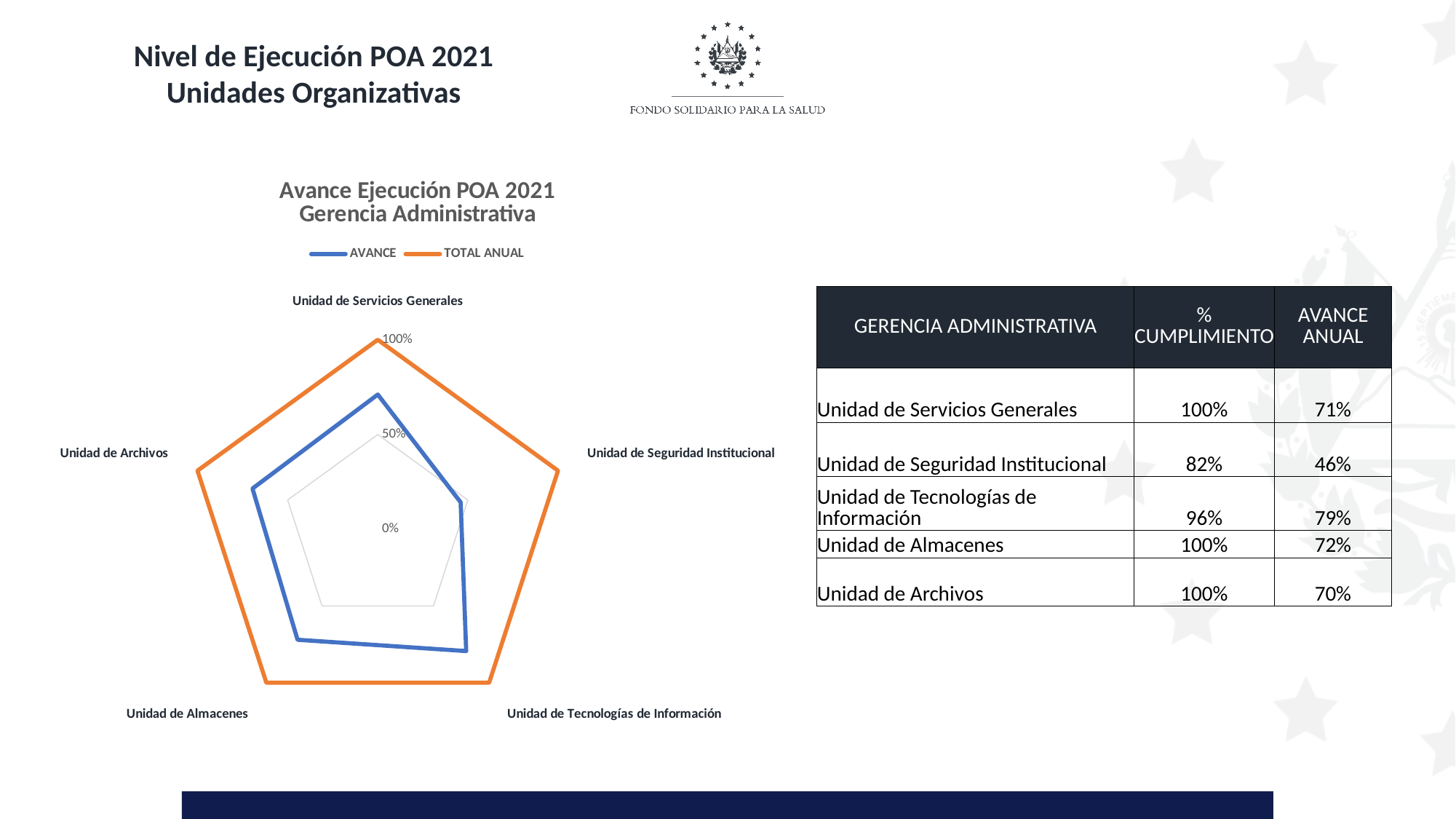
What kind of chart is shown on the slide? radar chart Is the TOTAL ANUAL value for Unidad de Archivos greater or less than 50%? greater According to the table on the slide, what is the AVANCE ANUAL for Unidad de Tecnologías de Información? 79% Which has the larger AVANCE value on the radar chart, Unidad de Servicios Generales or Unidad de Seguridad Institucional? Unidad de Servicios Generales What is the title of the radar chart? Avance Ejecución POA 2021 Gerencia Administrativa Is the AVANCE value for Unidad de Seguridad Institucional greater or less than 50%? less How many categories (axes) does the radar chart have? 5 Is the AVANCE value for Unidad de Servicios Generales greater or less than 50%? greater What are the two series named in the legend of the radar chart? AVANCE and TOTAL ANUAL How many series does the legend of the radar chart list? 2 Which category has the lowest AVANCE value on the radar chart? Unidad de Seguridad Institucional